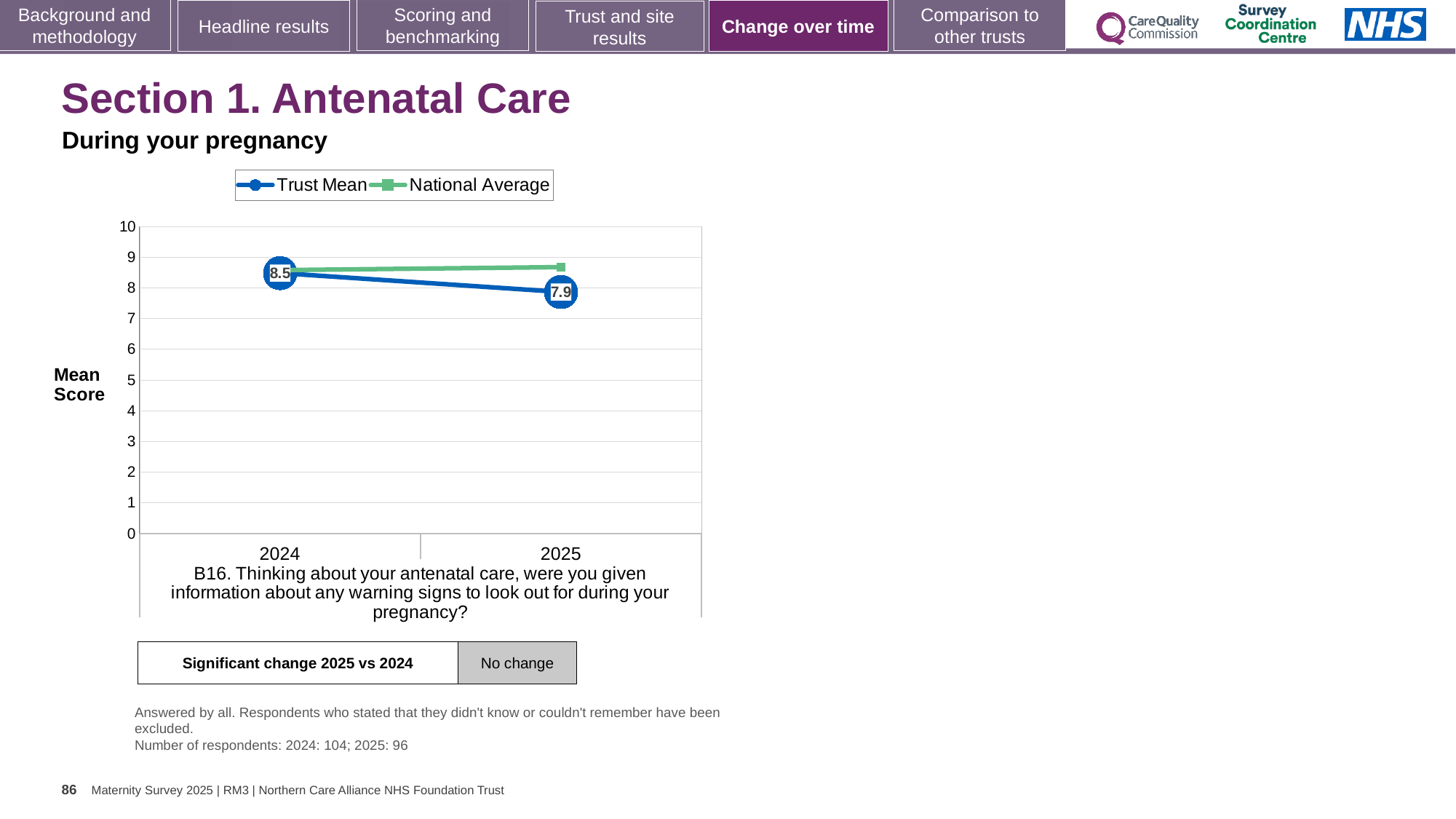
Does the Trust Mean rise or fall from 2024 to 2025? fall What kind of chart is shown on the slide? line chart By how much did the Trust Mean change from 2024 to 2025? 0.6 Which year has the lowest Trust Mean? 2025 Which year has the higher Trust Mean, 2024 or 2025? 2024 Is the National Average value for 2025 greater or less than 8? greater What is the label on the y axis of the chart? Mean Score What is the Trust Mean value for 2025? 7.9 How many series does the chart legend list? 2 In 2025, which is higher, the Trust Mean or the National Average? National Average How many years are shown on the x axis of the chart? 2 What is the Trust Mean value for 2024? 8.5